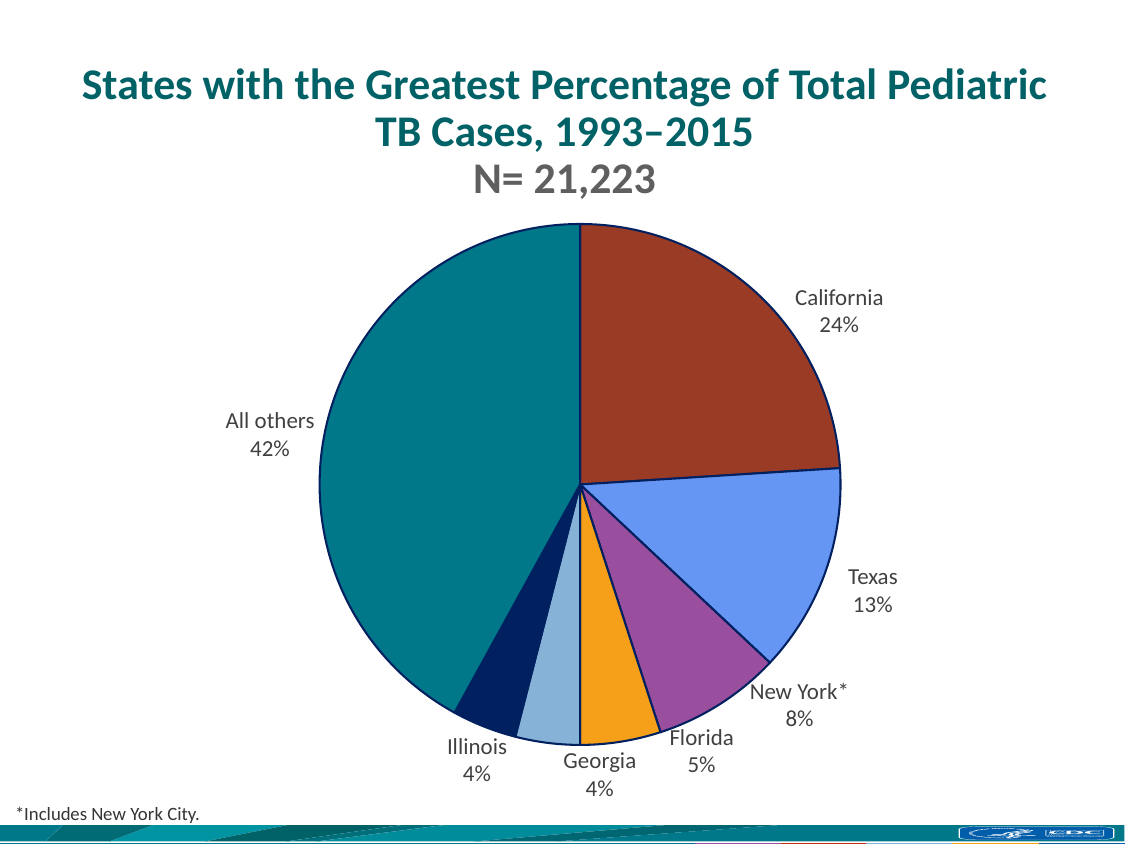
What is the total N stated in the chart title? 21,223 What percentage of total pediatric TB cases is attributed to Texas? 13% How many slices does the pie chart have? 7 Which named state has the largest share of pediatric TB cases? California What share of the pie does New York* account for? 8% What is the difference in percentage points between California and Texas? 11 Which has a larger share, Florida or New York*? New York* What does the asterisk next to New York indicate, according to the footnote? Includes New York City. What kind of chart is shown on the slide? pie chart What percentage of total pediatric TB cases is attributed to California? 24% Which slice of the pie is the largest? All others What percentage is shown for Florida? 5%